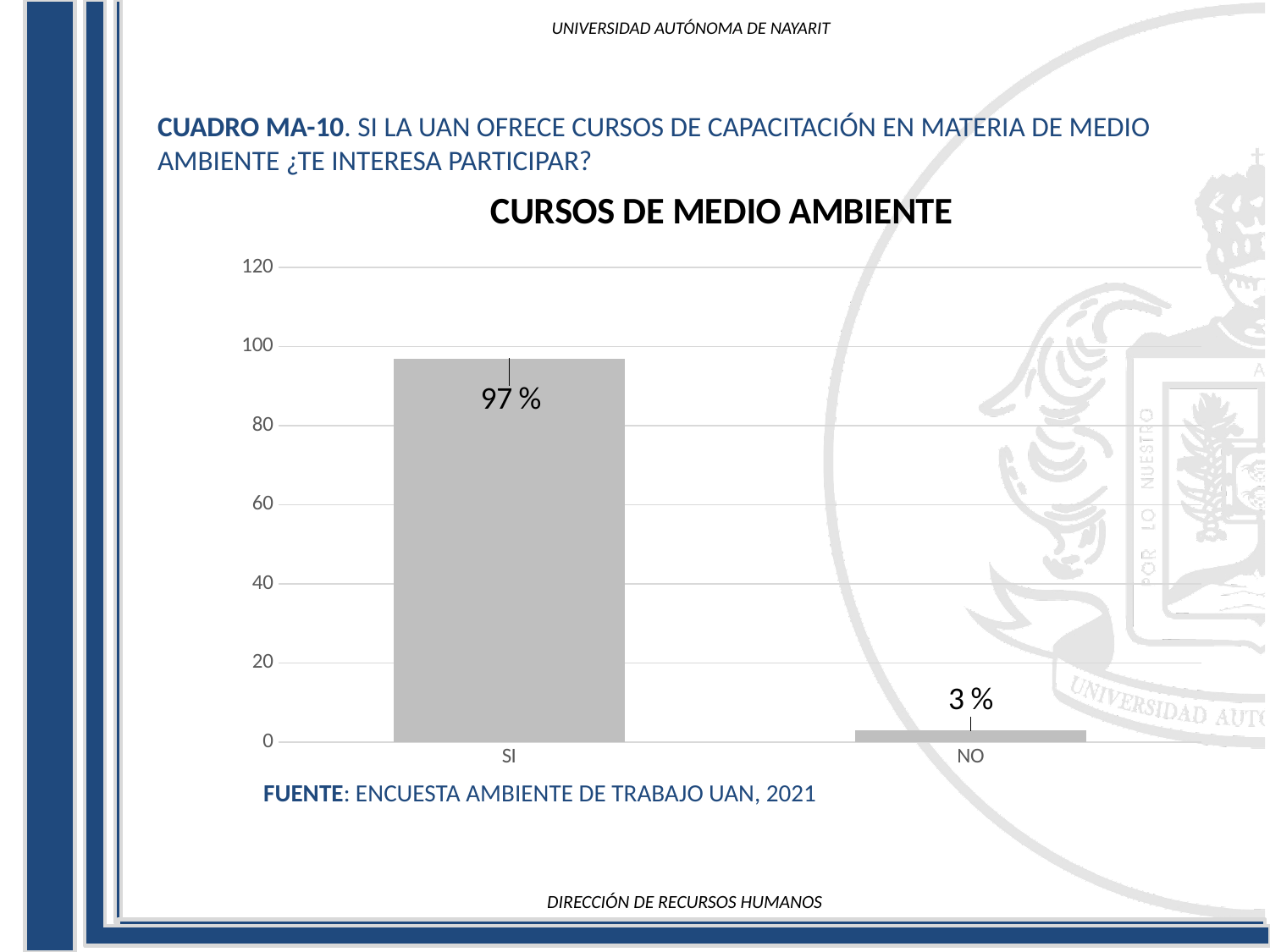
Is the value for NO greater or less than 20? less What is the title of the chart? CURSOS DE MEDIO AMBIENTE What is the difference between the values for SI and NO? 94 % Is the value for SI greater or less than 80? greater What is the highest value shown on the y axis? 120 What is the value for NO? 3 % What kind of chart is shown? bar chart How many categories are shown on the x axis? 2 Which is larger, the value for SI or the value for NO? SI Which category has the lowest value? NO What is the value for SI? 97 % Which category has the highest value? SI